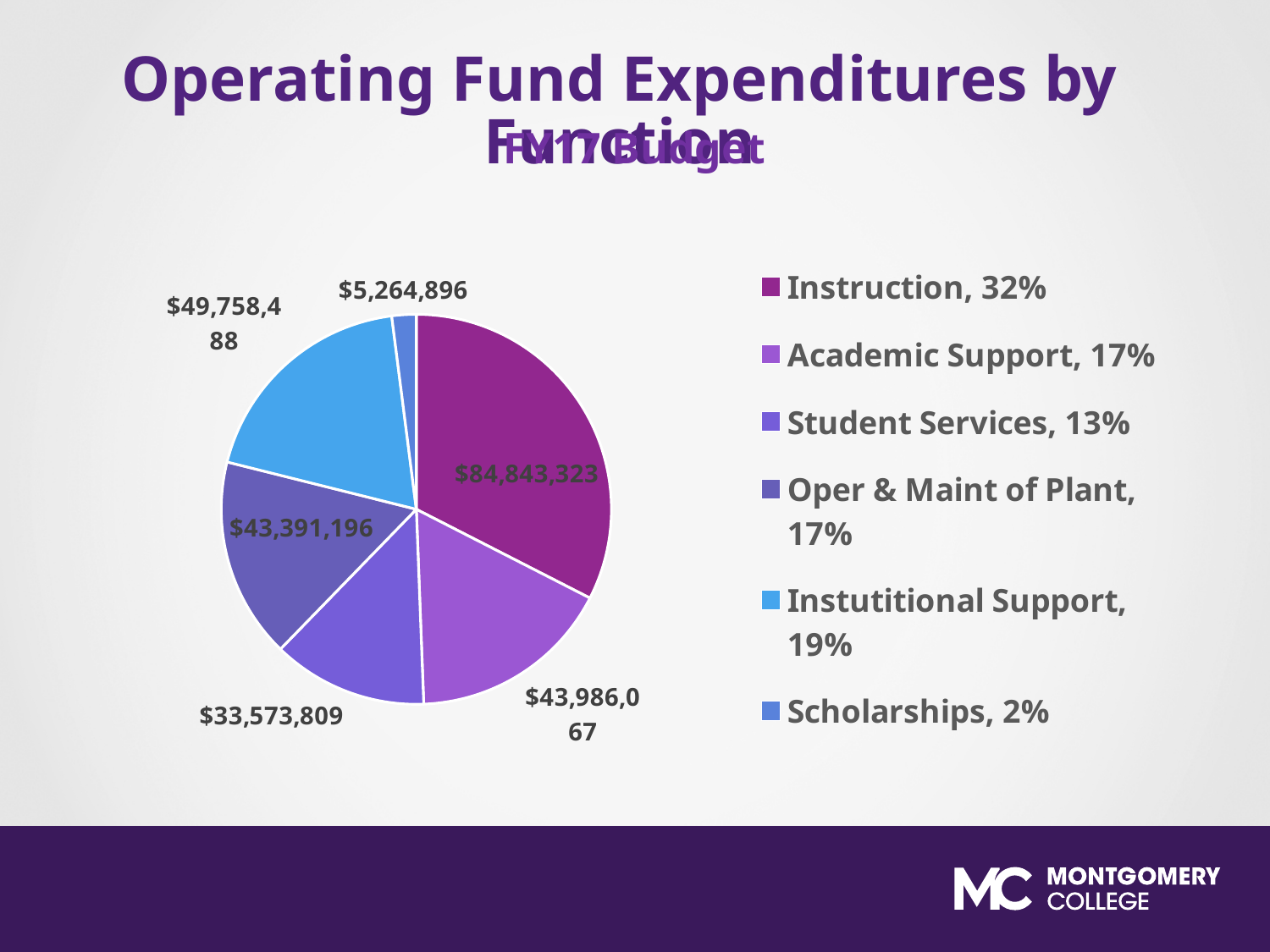
What is the difference between the Instruction value and the Instutitional Support value? $35,084,835 Which category has the largest slice of the pie? Instruction What is the value shown for Scholarships? $5,264,896 Which category has the smallest slice of the pie? Scholarships What share of the pie does Instutitional Support represent? 19% What is the value shown for Instruction? $84,843,323 What is the difference between the Academic Support value and the Student Services value? $10,412,258 What kind of chart is shown on the slide? pie chart How many slices does the pie chart have? 6 What share of the pie does Instruction represent? 32% Which is larger, Academic Support or Student Services? Academic Support What is the value shown for Oper & Maint of Plant? $43,391,196